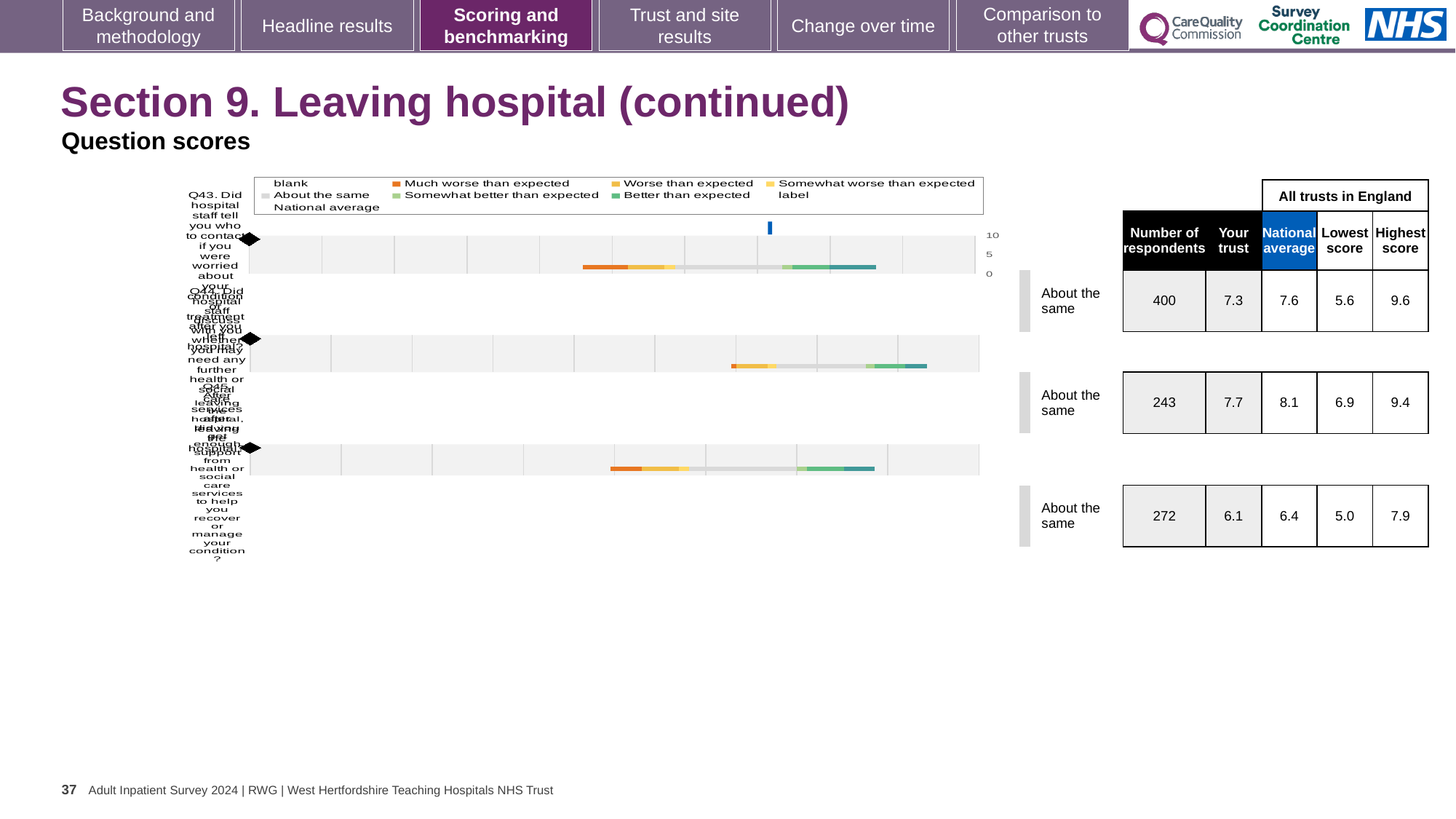
In the table next to the chart, what is the number of respondents for the first row (Q43)? 400 Which row has the lowest 'Your trust' score? Q45 (third row), 6.1 For the first row (Q43), which is larger: the 'Your trust' score or the national average? National average For the third row (Q45), what is the difference between the national average and the 'Your trust' score? 0.3 What is the highest score among all trusts in England for the third row (Q45)? 7.9 What is the lowest score among all trusts in England for the second row (Q44)? 6.9 How many question rows (bars) are plotted in the chart? 3 What is the 'Your trust' score for the first row (Q43)? 7.3 Which row has the highest 'Your trust' score? Q44 (second row), 7.7 What kind of chart is shown on the slide? bar chart What is the national average for the second row (Q44)? 8.1 What benchmark category is shown beside each of the three rows? About the same